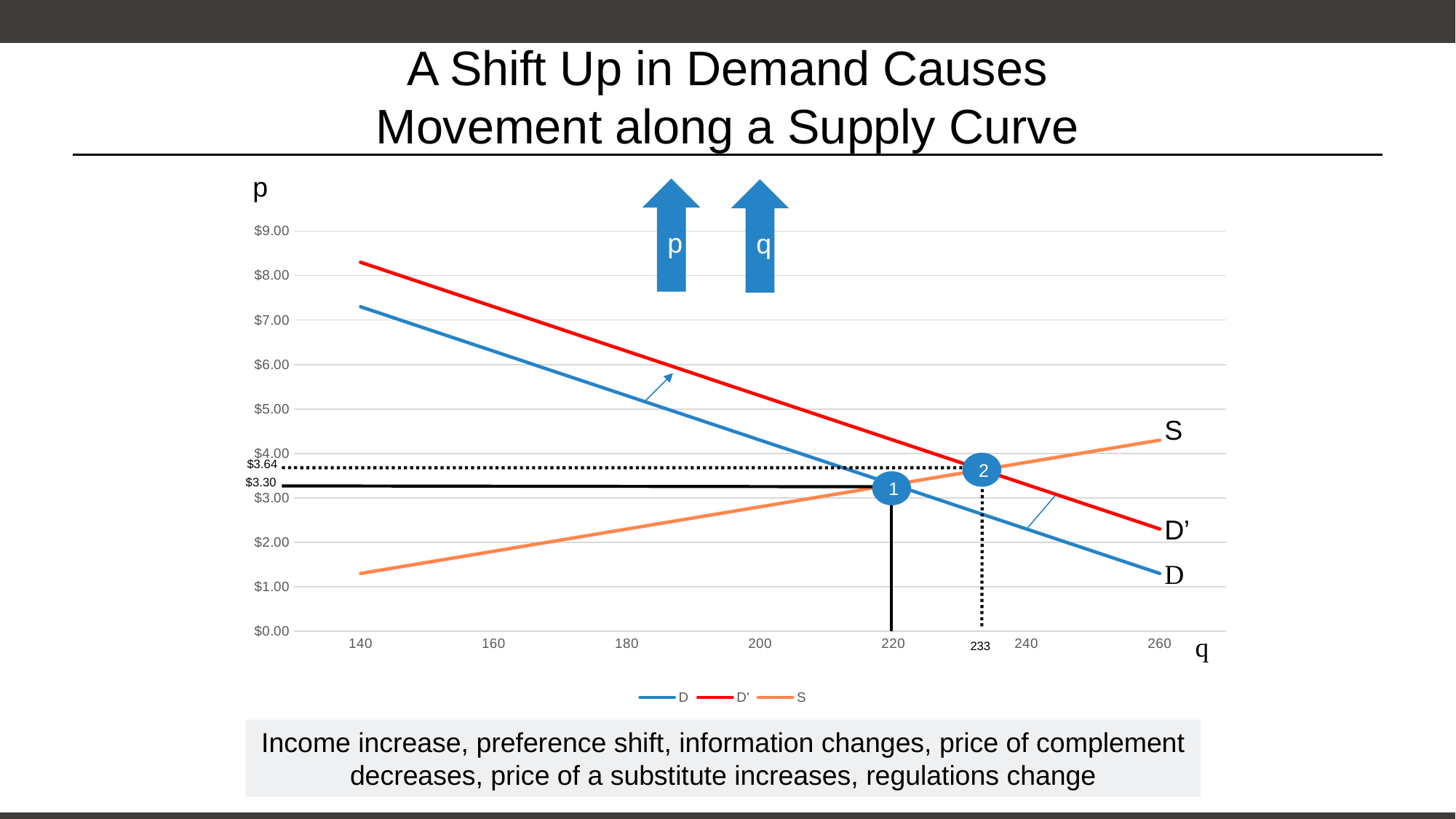
What are the series names listed in the legend? D, D', S Does the S line rise or fall as q increases? rise What is the price at equilibrium point 2? $3.64 Is the value of the D' line at q = 140 greater or less than $8.00? greater By how much does the price rise from equilibrium point 1 to equilibrium point 2? $0.34 What is the quantity at equilibrium point 2? 233 How many series does the legend list? 3 By how much does the quantity increase from equilibrium point 1 to equilibrium point 2? 13 What kind of chart is shown on the slide? line chart Which equilibrium point has the higher price, point 1 or point 2? point 2 What is the quantity at equilibrium point 1? 220 What is the price at equilibrium point 1? $3.30